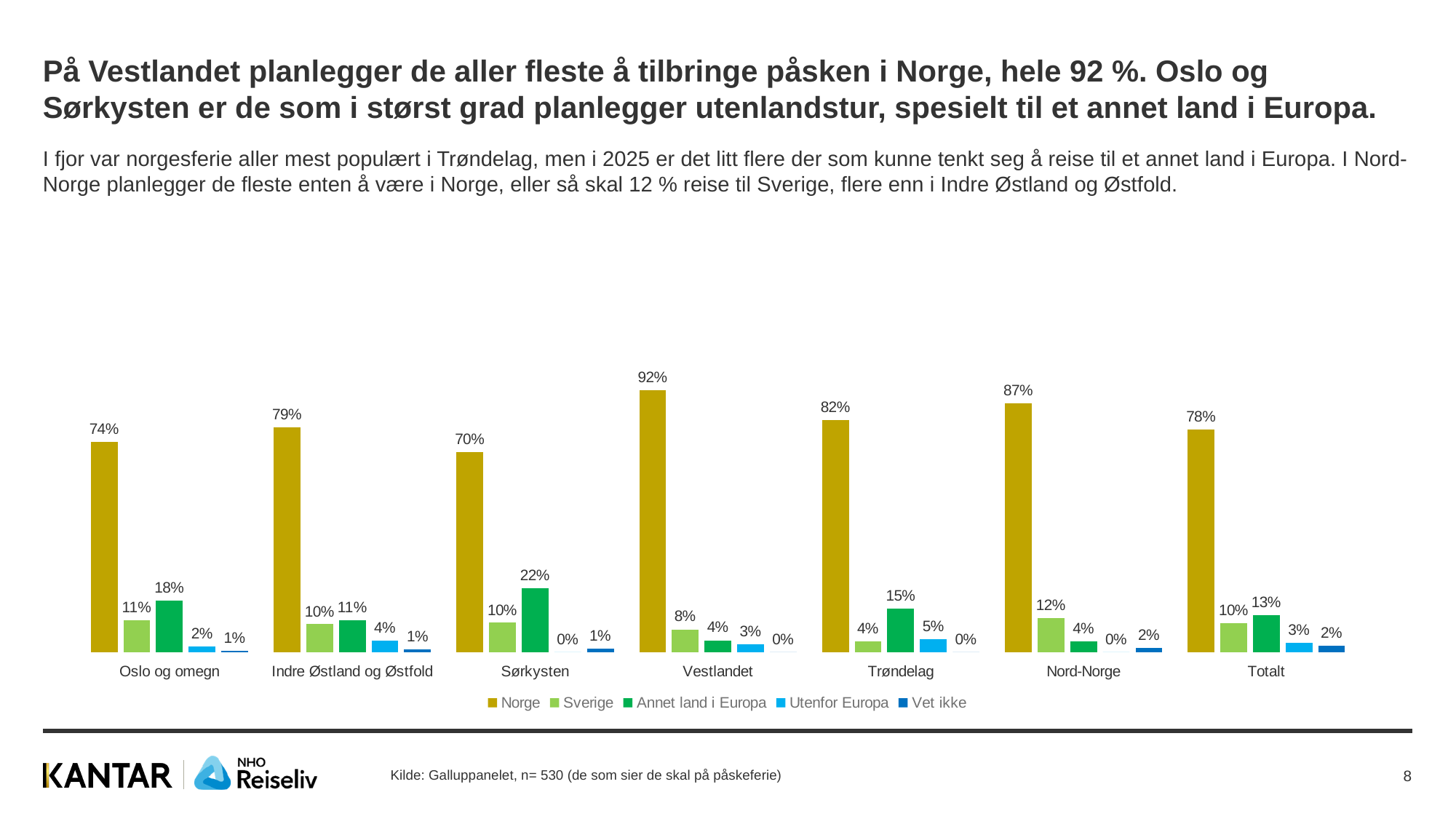
What is the value for Annet land i Europa in Sørkysten? 22% What is the value for Norge in Vestlandet? 92% What is the value for Sverige in Nord-Norge? 12% What is the value for Utenfor Europa in Trøndelag? 5% Which series is shown in dark yellow/gold in the legend? Norge Which region has the highest value for Norge? Vestlandet How many series does the legend list? 5 Which region has the lowest value for Norge? Sørkysten What is the difference between the Norge value for Vestlandet and the Norge value for Oslo og omegn? 18% Which is larger: the Annet land i Europa value for Oslo og omegn or for Trøndelag? Oslo og omegn What kind of chart is shown on the slide? Bar chart How many regions (categories) are shown on the x axis? 7